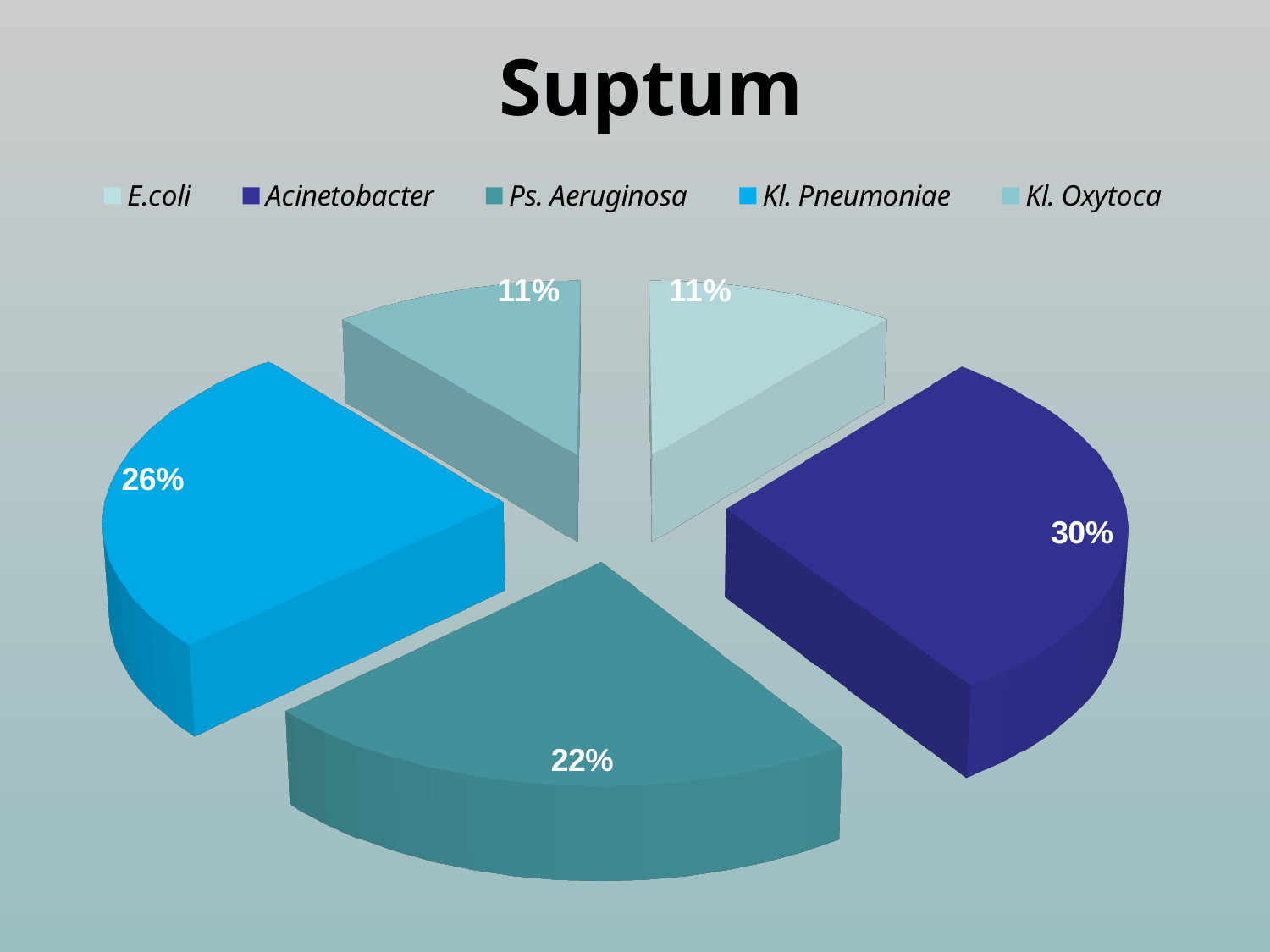
What is the difference in percentage points between Acinetobacter and Ps. Aeruginosa? 8 percentage points What is the value shown for Kl. Pneumoniae? 26% What is the value shown for Kl. Oxytoca? 11% Which category has the largest share of the pie? Acinetobacter What percentage of the pie does Acinetobacter account for? 30% What is the value shown for Ps. Aeruginosa? 22% Which is larger, the share for Kl. Pneumoniae or the share for Ps. Aeruginosa? Kl. Pneumoniae How many categories does the legend list? 5 What type of chart is shown on the slide? Pie chart What is the title of the chart? Suptum What is the value shown for E.coli? 11% What colour is the slice for Acinetobacter? Dark blue